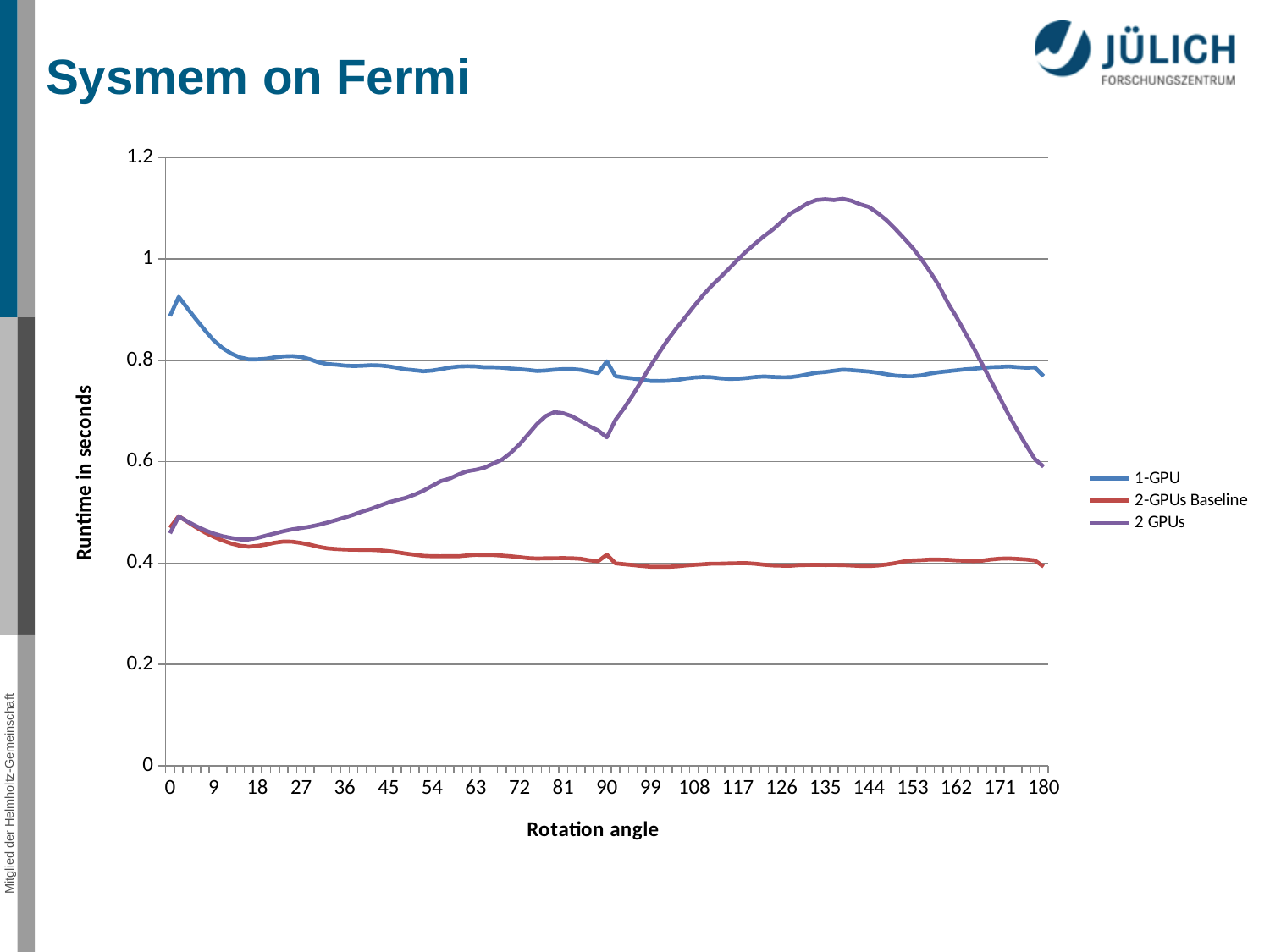
Is the runtime for the 2 GPUs series at rotation angle 135 greater or less than 1? greater At rotation angle 135, which series has the larger runtime, 1-GPU or 2 GPUs? 2 GPUs Does the runtime of the 2 GPUs series rise or fall between rotation angles 135 and 180? fall What kind of chart is shown on the slide? line chart Which series reaches the highest runtime anywhere on the chart? 2 GPUs Which series has the lowest runtime across the whole rotation angle range? 2-GPUs Baseline What is the label of the x axis? Rotation angle How many series does the legend list? 3 At rotation angle 45, which series has the larger runtime, 1-GPU or 2 GPUs? 1-GPU Is the runtime for the 2 GPUs series at rotation angle 0 greater or less than 0.6? less Is the runtime for the 1-GPU series at rotation angle 90 greater or less than 1? less What is the label of the y axis? Runtime in seconds